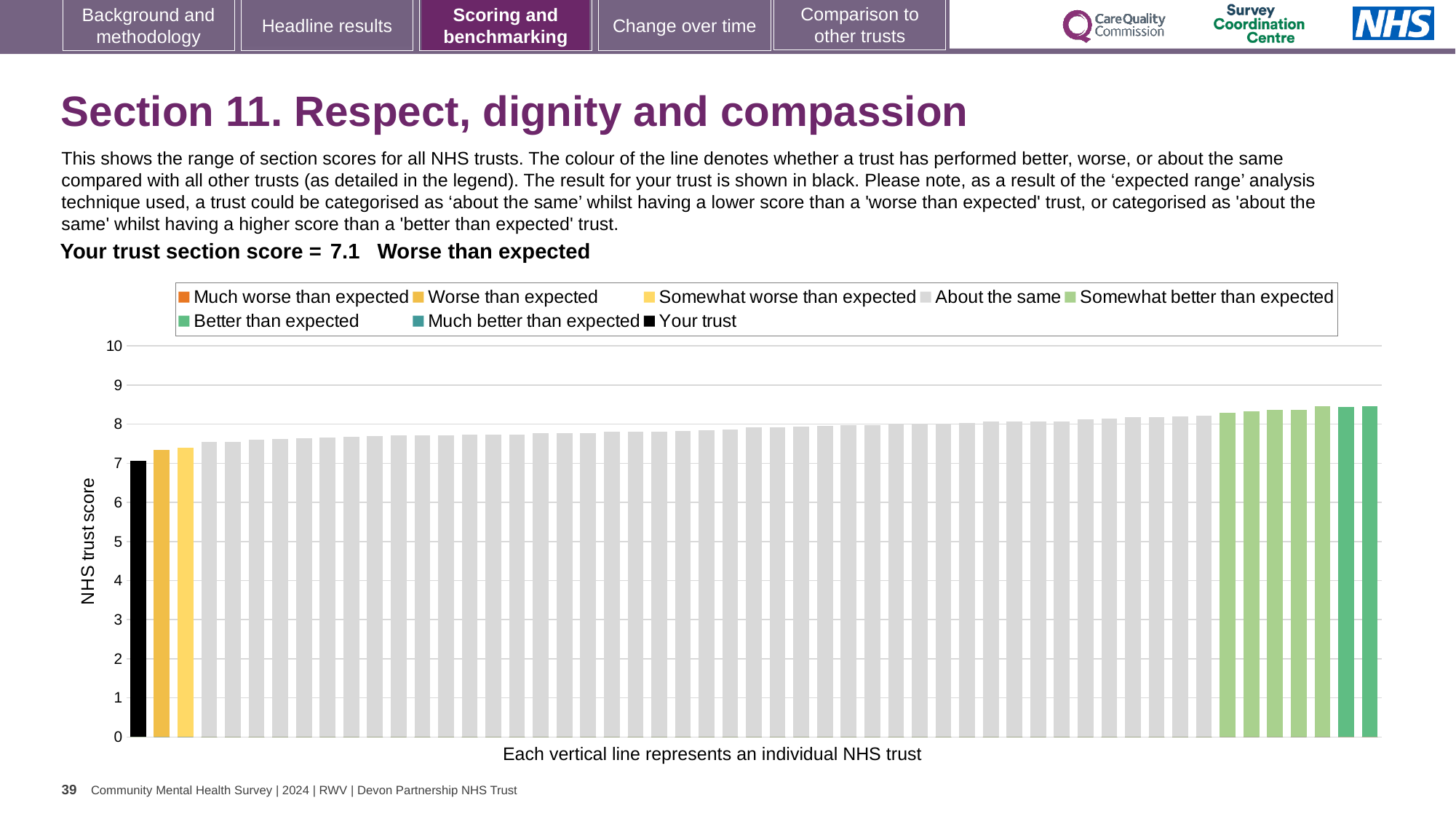
Do the bar values rise or fall from left to right along the x axis? Rise How many bars are coloured as 'Worse than expected'? 1 How many bars are coloured as 'Much better than expected'? 0 What is the label on the vertical axis of the chart? NHS trust score Is the value for your trust greater or less than 8? less How many entries does the chart legend list? 8 What is the section score for your trust shown on the slide? 7.1 Which bar in the chart is the lowest? Your trust (the black bar) Is the value of the highest bar in the chart greater or less than 8? greater What kind of chart is shown on the slide? Bar chart Is the value of the highest bar in the chart greater or less than 9? less Which category does your trust's section score fall into? Worse than expected